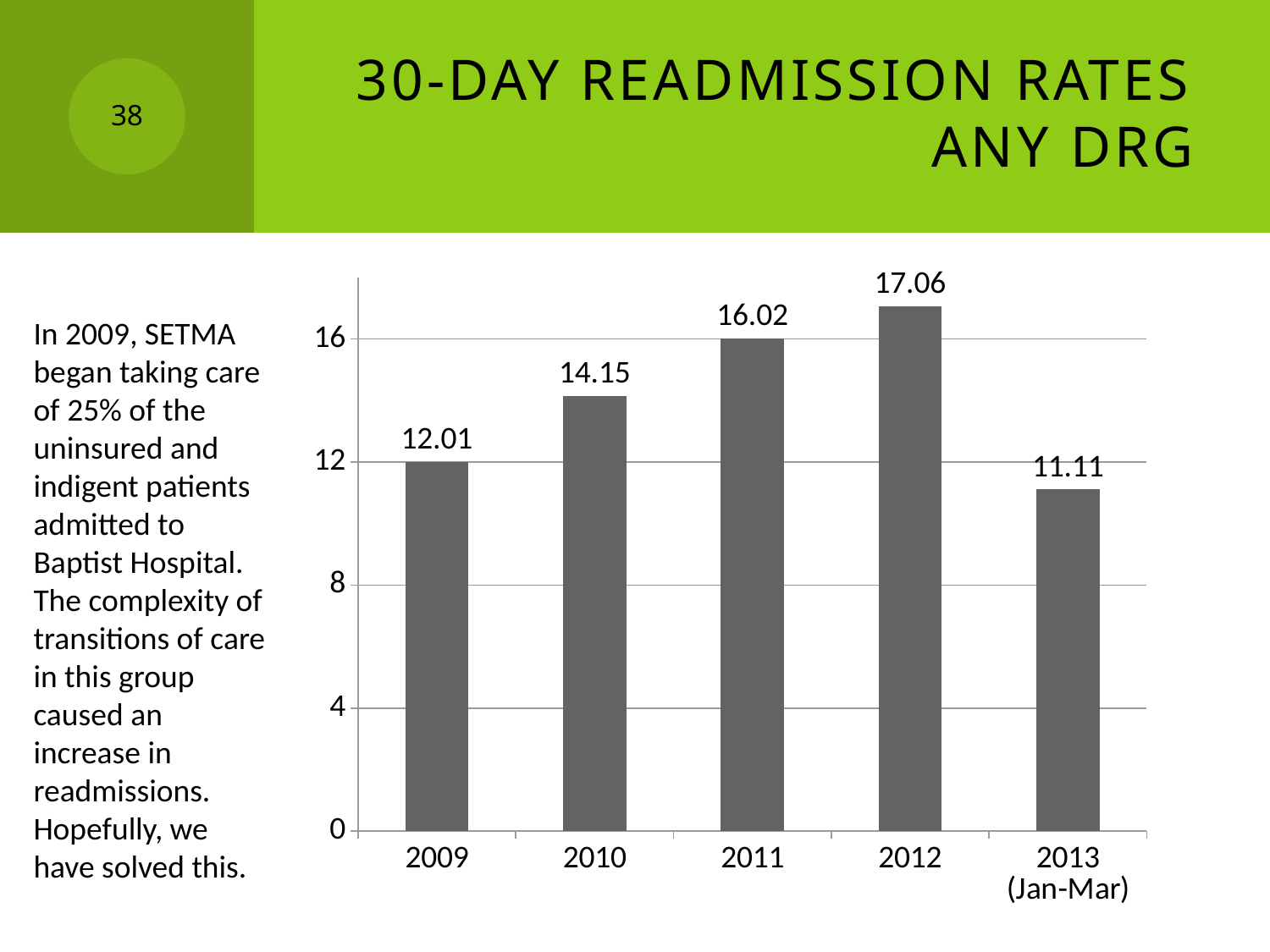
What is the difference between the values for 2011 and 2010? 1.87 What is the 30-day readmission rate shown for 2009? 12.01 Which category has the lowest readmission rate? 2013 (Jan-Mar) What is the value shown for 2013 (Jan-Mar)? 11.11 What is the difference between the values for 2012 and 2009? 5.05 Which year has the highest readmission rate? 2012 What is the value shown for 2012? 17.06 Which is larger, the value for 2010 or the value for 2011? 2011 Is the value for 2012 greater or less than 16? greater How many categories are shown on the x axis? 5 What kind of chart is shown on the slide? bar chart Do the values rise or fall from 2009 to 2012? rise